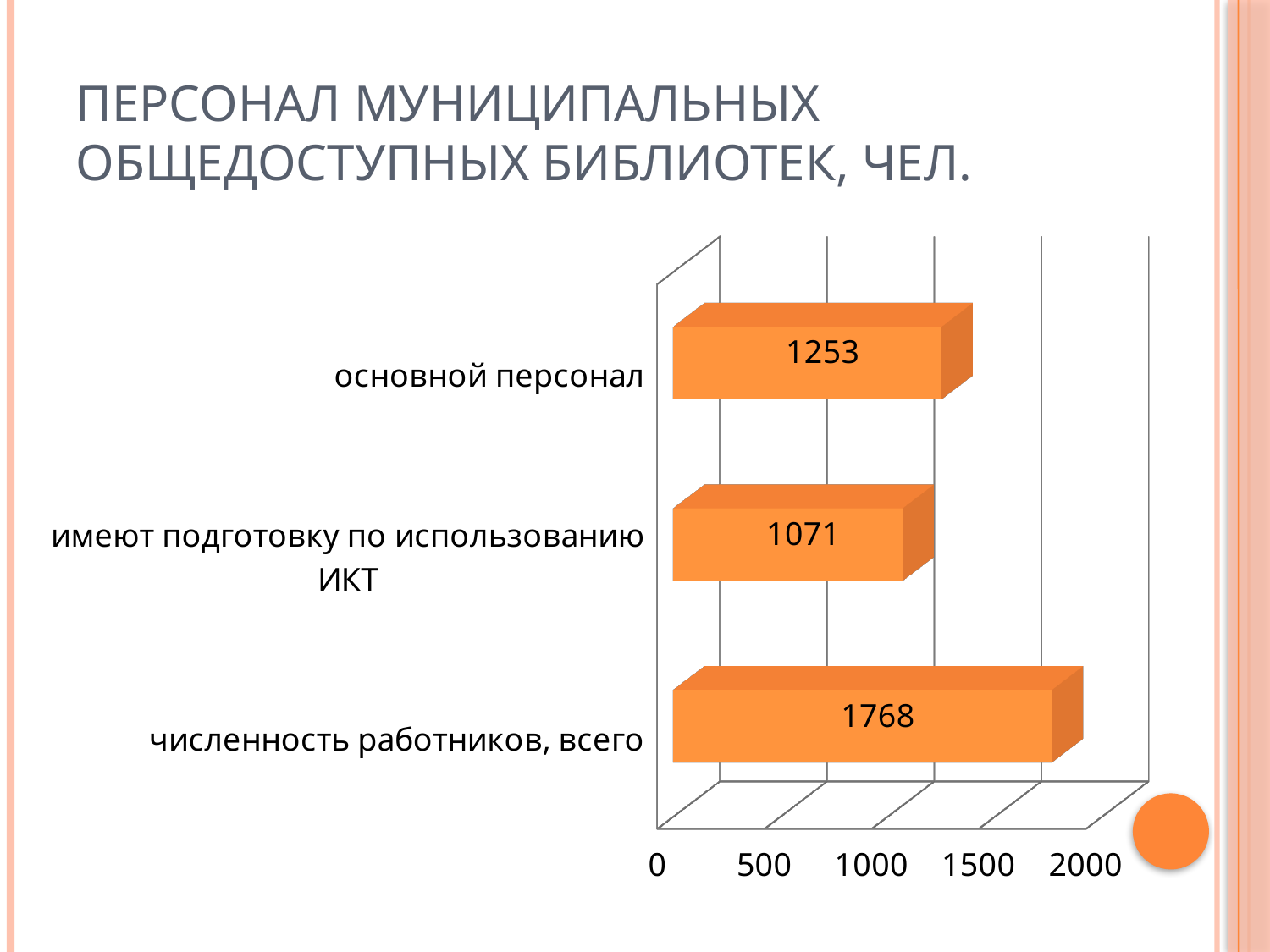
What kind of chart is shown on the slide? bar chart How many categories are shown in the chart? 3 What is the value for "имеют подготовку по использованию ИКТ"? 1071 What is the value for "численность работников, всего"? 1768 What is the difference between "численность работников, всего" and "основной персонал"? 515 Is the value for "численность работников, всего" greater or less than 1500? greater What is the title of the slide? ПЕРСОНАЛ МУНИЦИПАЛЬНЫХ ОБЩЕДОСТУПНЫХ БИБЛИОТЕК, ЧЕЛ. What is the value for "основной персонал"? 1253 Which is larger: "основной персонал" or "имеют подготовку по использованию ИКТ"? основной персонал Which category has the lowest value? имеют подготовку по использованию ИКТ What is the difference between "основной персонал" and "имеют подготовку по использованию ИКТ"? 182 Which category has the highest value? численность работников, всего